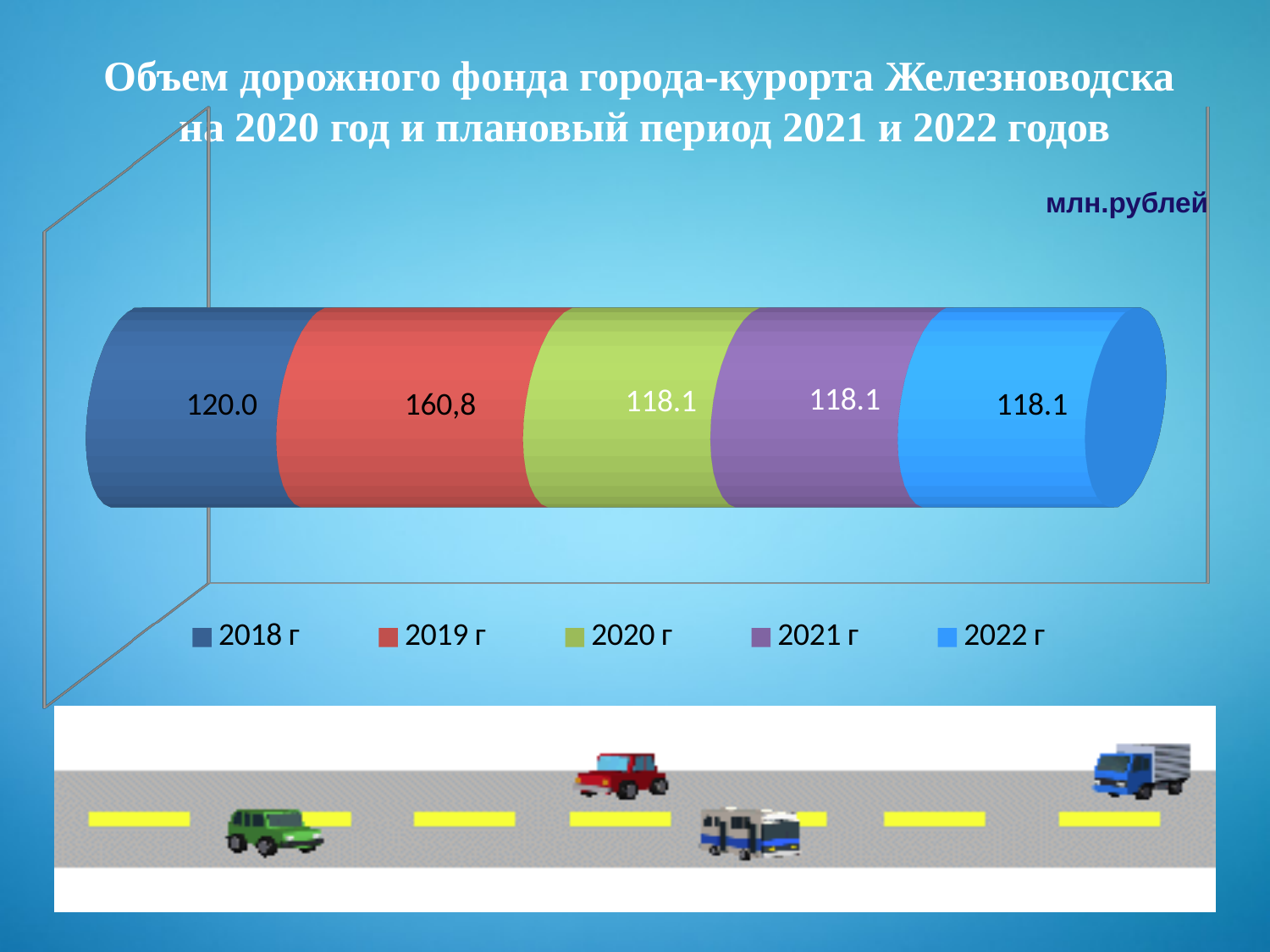
What is the difference between the values for 2019 г and 2021 г? 42.7 What is the difference between the values for 2019 г and 2018 г? 40.8 What unit of measurement is indicated on the chart? млн.рублей What is the value shown for 2019 г? 160,8 What is the value shown for 2018 г? 120.0 What kind of chart is shown on the slide? Bar chart Which year has the highest value? 2019 г How many segments make up the stacked bar? 5 How many entries does the legend list? 5 What is the value shown for 2020 г? 118.1 Which is larger, the value for 2018 г or the value for 2020 г? 2018 г What is the value shown for 2022 г? 118.1